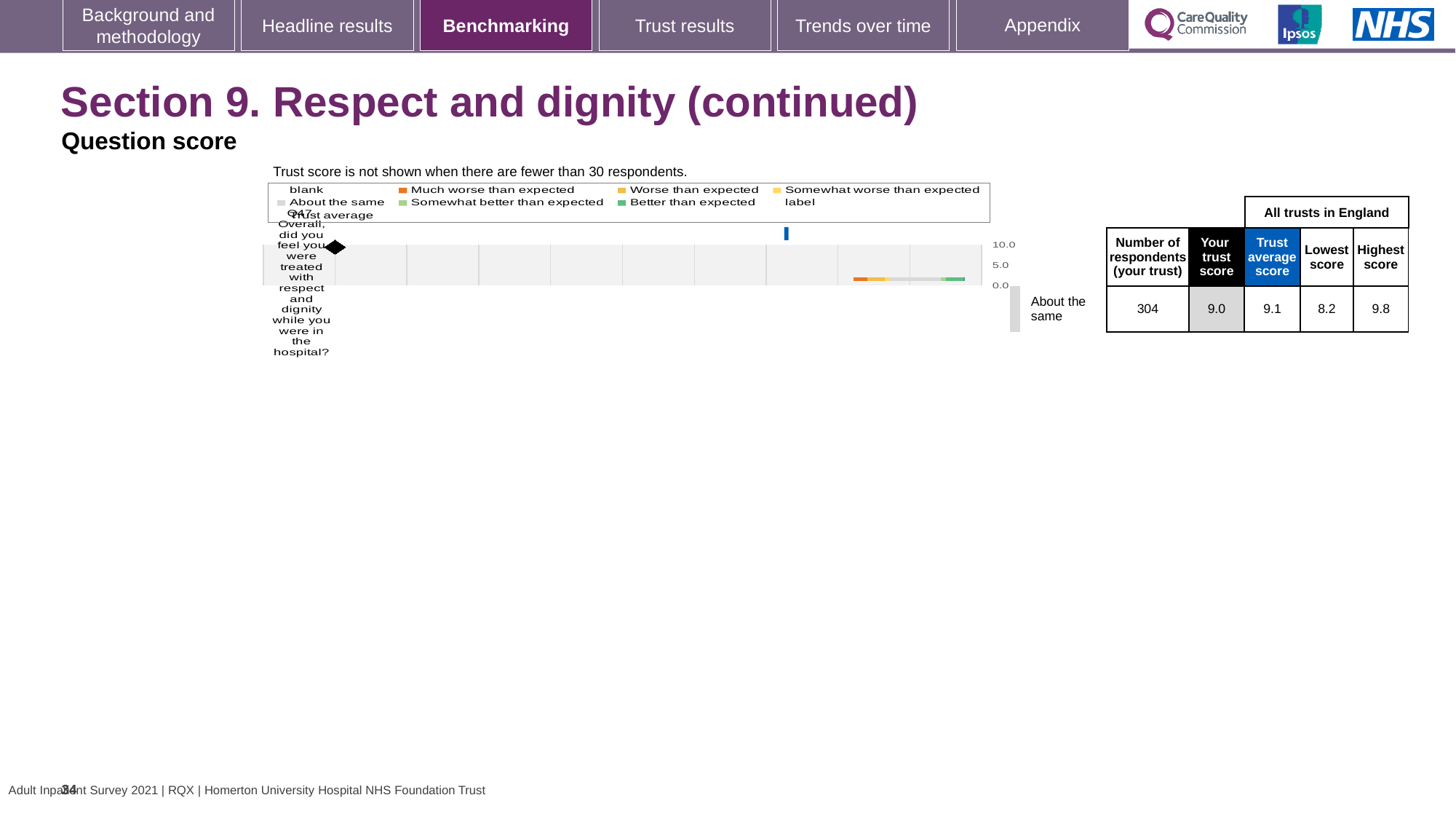
Which is larger for Q47: your trust score or the trust average score? Trust average score According to the table beside the chart, what is the highest score among all trusts in England for Q47? 9.8 What benchmark category label is shown next to the chart for Q47? About the same According to the table beside the chart, what is the number of respondents for your trust for Q47? 304 According to the table beside the chart, what is the trust average score for Q47? 9.1 What kind of chart is shown on the slide? bar chart Which question number is plotted on the chart? Q47 What is the difference between the highest score (9.8) and the lowest score (8.2) shown in the table for Q47? 1.6 How many questions (categories) are plotted on the chart? 1 According to the table beside the chart, what is your trust score for Q47? 9.0 What is the highest value shown on the chart's numeric axis? 10.0 According to the table beside the chart, what is the lowest score among all trusts in England for Q47? 8.2